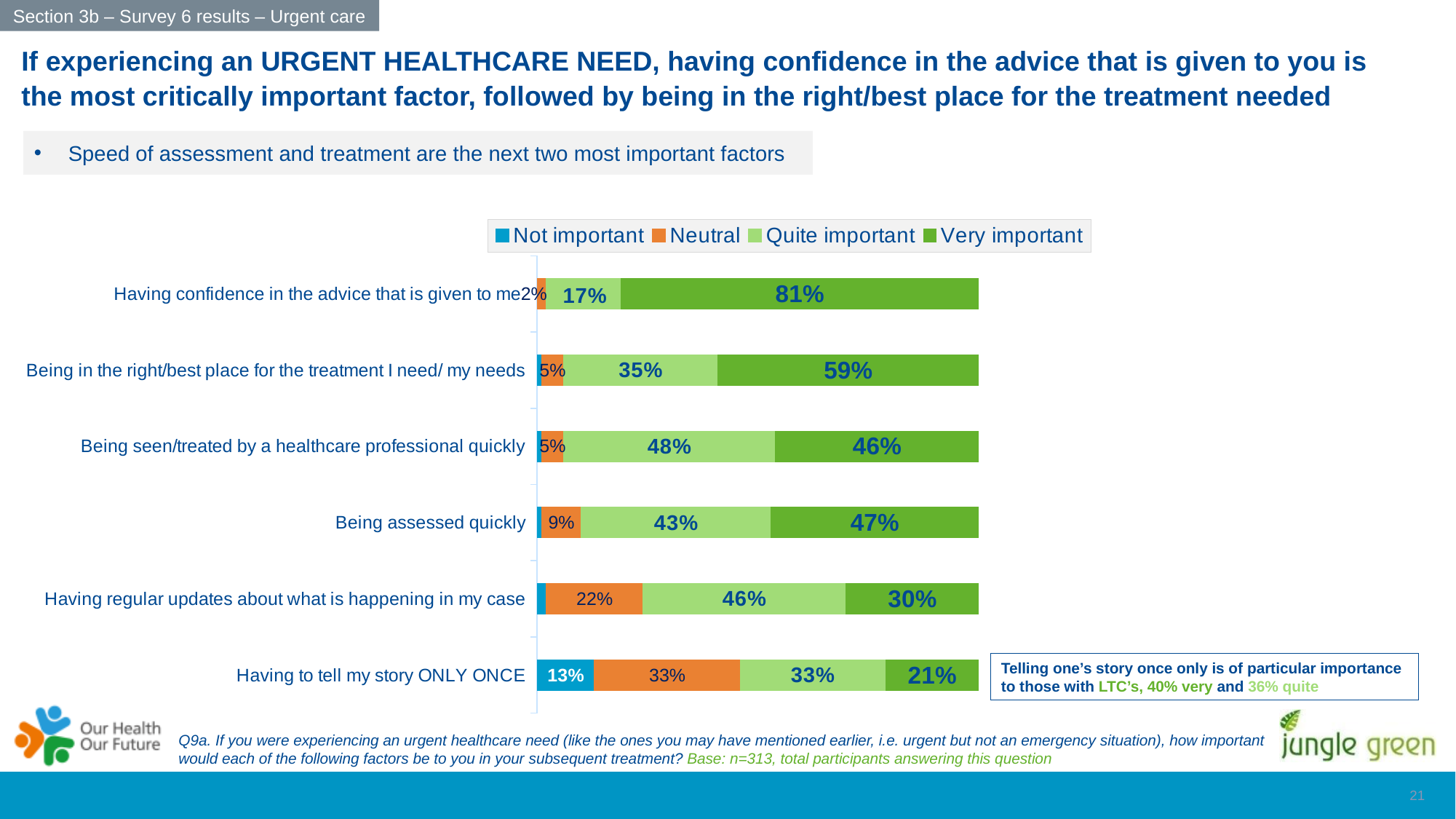
What percentage rated 'Being in the right/best place for the treatment I need/ my needs' as Quite important? 35% How many factors are shown in the chart? 6 Which factor has the highest Very important percentage? Having confidence in the advice that is given to me Which factor has the lowest Very important percentage? Having to tell my story ONLY ONCE What is the Neutral value for 'Having regular updates about what is happening in my case'? 22% Which is larger for 'Being seen/treated by a healthcare professional quickly': the Quite important share or the Very important share? Quite important What percentage rated 'Having confidence in the advice that is given to me' as Very important? 81% Which colour represents 'Very important' in the legend? Dark green How many series does the legend list? 4 What is the difference between the Very important percentages for 'Having confidence in the advice that is given to me' and 'Being in the right/best place for the treatment I need/ my needs'? 22 percentage points What type of chart is shown on the slide? Stacked bar chart What is the Not important value for 'Having to tell my story ONLY ONCE'? 13%